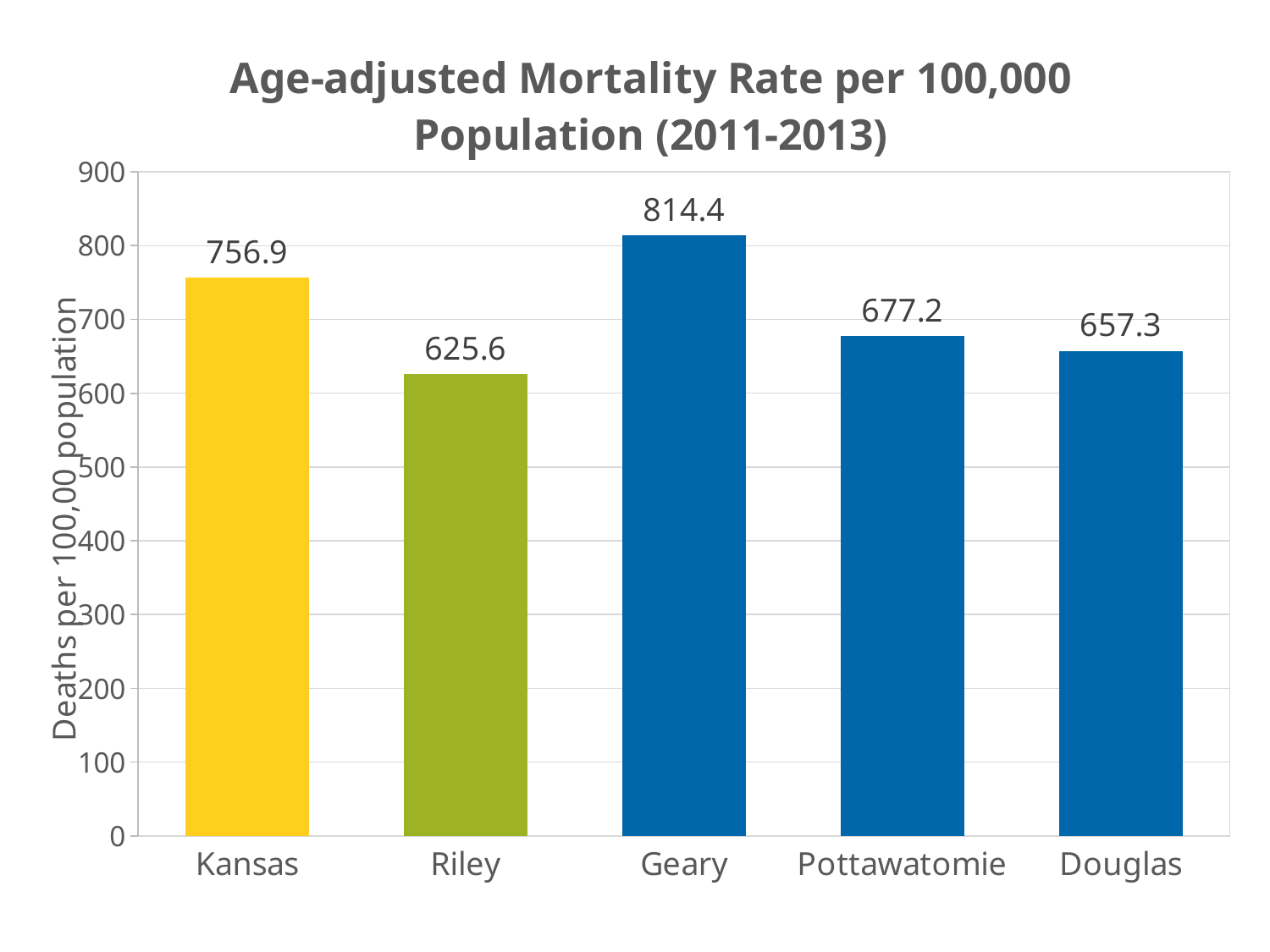
Which category has the highest mortality rate? Geary What is the difference between the mortality rates of Geary and Riley? 188.8 What kind of chart is shown on the slide? Bar chart Which has a higher mortality rate, Pottawatomie or Douglas? Pottawatomie How many categories are shown on the x axis? 5 What is the age-adjusted mortality rate for Riley? 625.6 What is the label of the vertical axis? Deaths per 100,00 population Which category has the lowest mortality rate? Riley What is the age-adjusted mortality rate for Kansas? 756.9 Is the value for Geary greater or less than 800? greater What is the age-adjusted mortality rate for Pottawatomie? 677.2 What is the difference between the mortality rates of Kansas and Douglas? 99.6